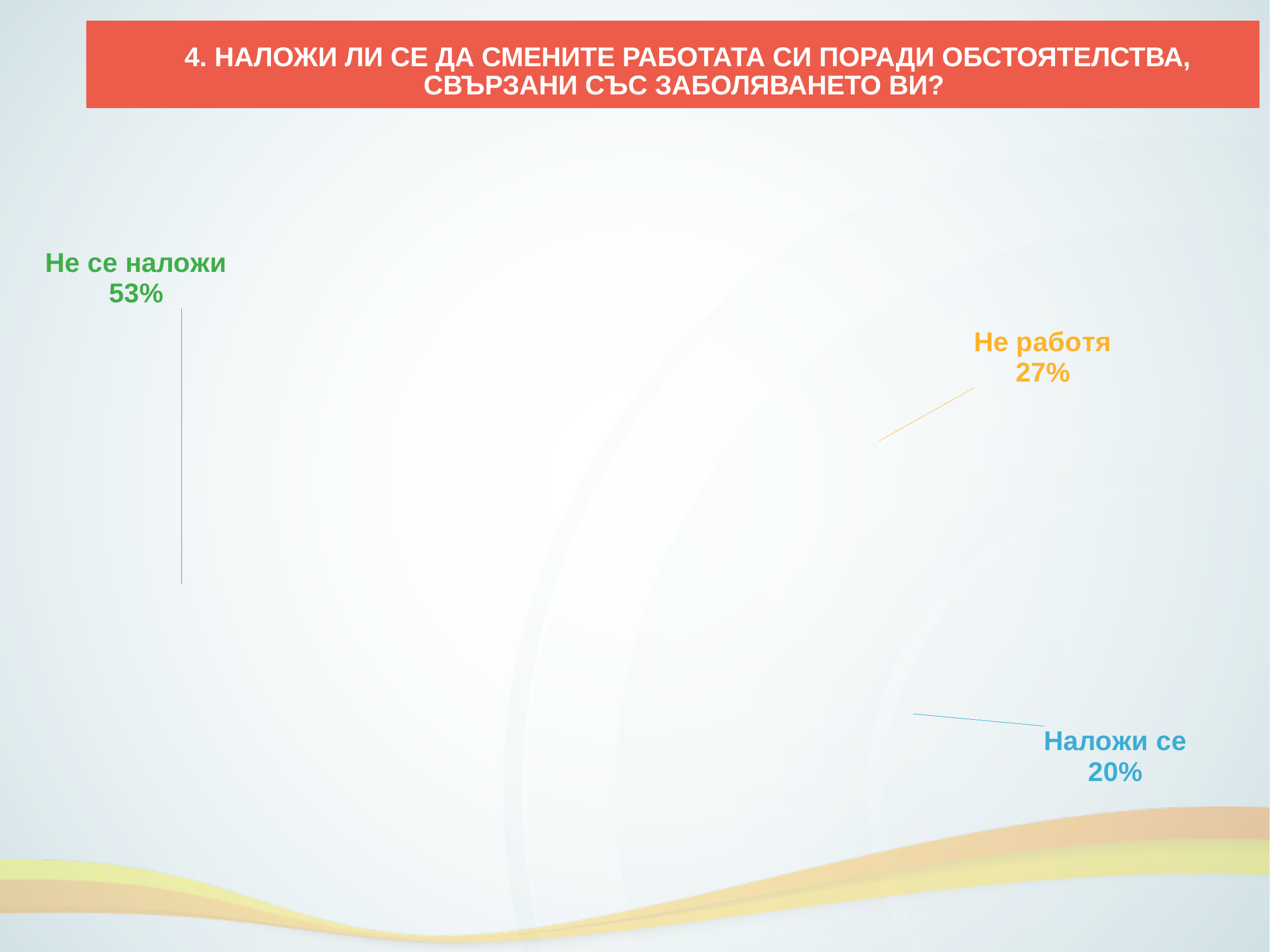
What is the title of the slide above the chart? 4. НАЛОЖИ ЛИ СЕ ДА СМЕНИТЕ РАБОТАТА СИ ПОРАДИ ОБСТОЯТЕЛСТВА, СВЪРЗАНИ СЪС ЗАБОЛЯВАНЕТО ВИ? What is the difference in percentage points between "Не работя" and "Наложи се"? 7 Which category has the lowest percentage? Наложи се What percentage is shown for "Не се наложи"? 53% How many categories are labelled on the chart? 3 What percentage is shown for "Не работя"? 27% Which is larger, the value for "Не работя" or the value for "Наложи се"? Не работя Which category has the highest percentage? Не се наложи What share of the total does "Не се наложи" represent? 53% Which is larger, the value for "Не се наложи" or the value for "Не работя"? Не се наложи What is the difference in percentage points between "Не се наложи" and "Наложи се"? 33 What percentage is shown for "Наложи се"? 20%